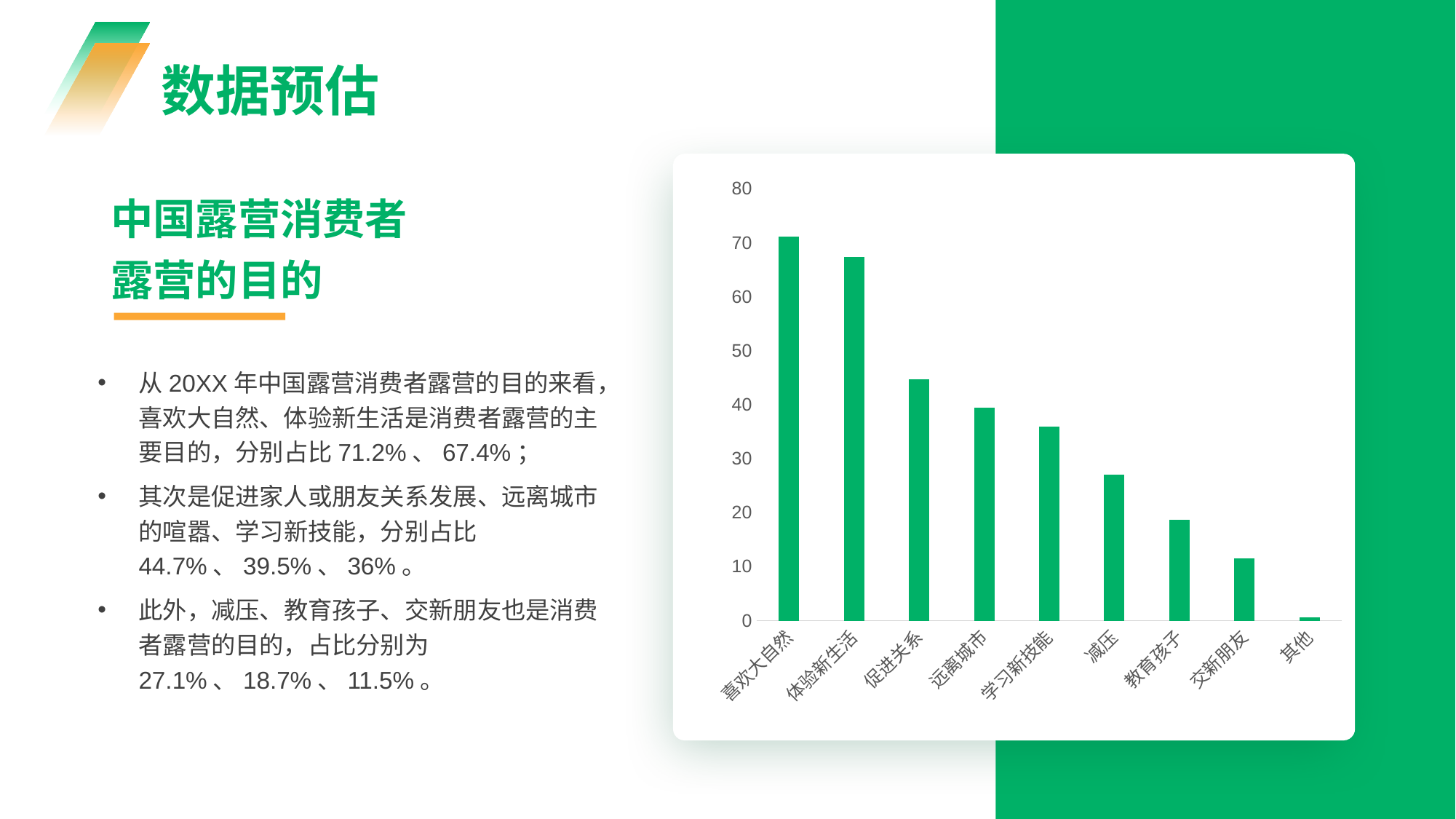
Is the value for 喜欢大自然 greater or less than 70? greater Is the value for 减压 greater or less than 30? less What kind of chart is shown on the slide? bar chart How many categories are shown on the x axis of the chart? 9 Is the value for 交新朋友 greater or less than 10? greater Do the bar values rise or fall from left to right along the x axis? fall Which category has the lowest bar in the chart? 其他 Which category has the highest bar in the chart? 喜欢大自然 What is the highest tick value shown on the vertical axis of the chart? 80 Which is larger, the value for 远离城市 or the value for 学习新技能? 远离城市